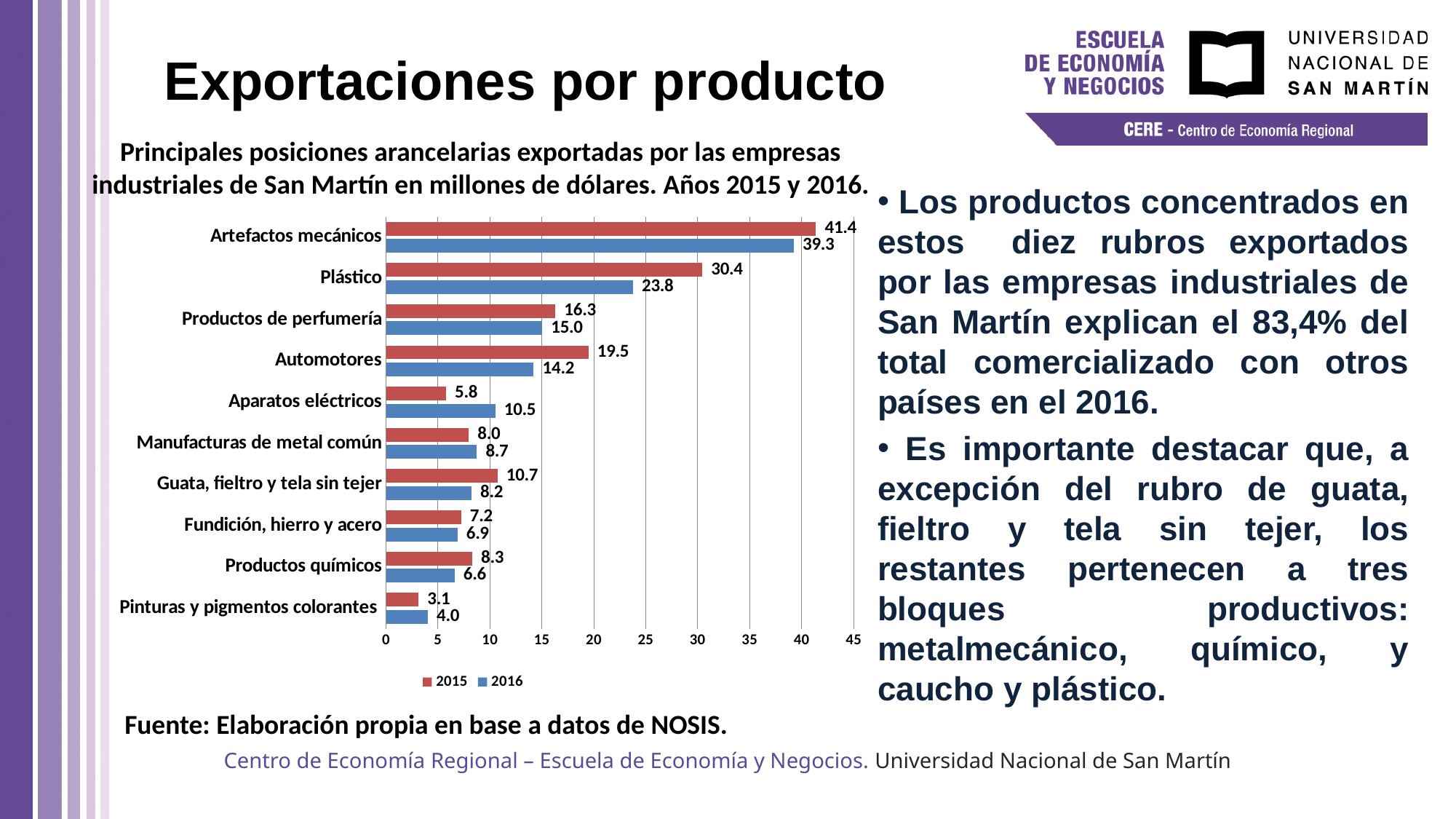
Which product had the highest export value in 2016? Artefactos mecánicos Which is larger for Guata, fieltro y tela sin tejer: the 2015 value or the 2016 value? 2015 What was the 2015 export value for Plástico? 30.4 Which product had the lowest export value in 2015? Pinturas y pigmentos colorantes What is the difference between the 2015 and 2016 export values for Plástico? 6.6 Is the 2015 value for Artefactos mecánicos greater or less than 40? greater How many product categories are shown in the chart? 10 How many series does the legend list? 2 What was the 2016 export value for Aparatos eléctricos? 10.5 Which colour represents the year 2016 in the chart? Blue What was the 2016 export value for Automotores? 14.2 What type of chart is shown on the slide? Bar chart